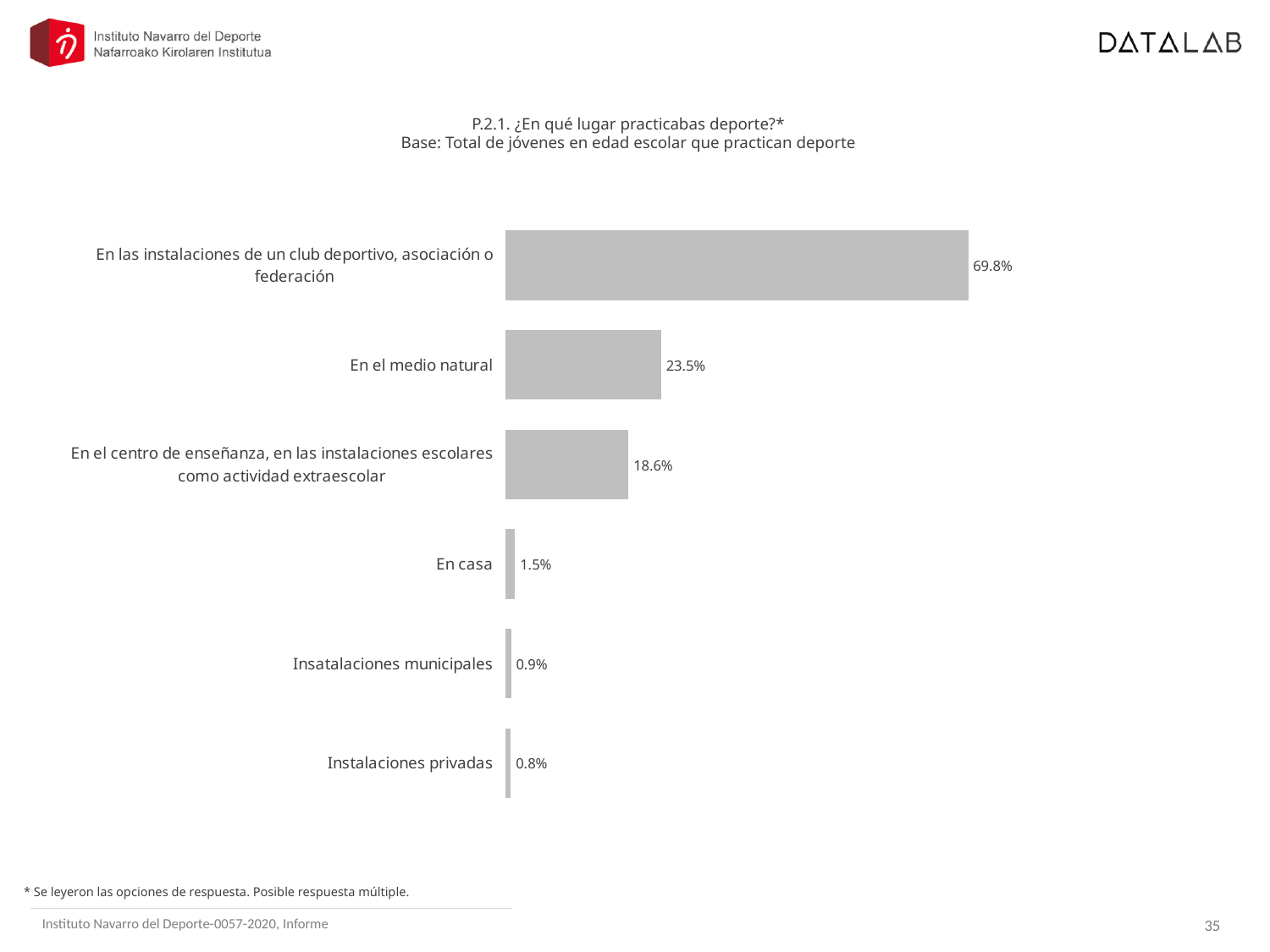
How many categories are shown in the chart? 6 What kind of chart is shown on the slide? Bar chart What is the difference between the highest and lowest values in the chart? 69% What is the difference between the values for "En el medio natural" and "En el centro de enseñanza, en las instalaciones escolares como actividad extraescolar"? 4.9% Which category has the lowest value? Instalaciones privadas What is the value for "En el medio natural"? 23.5% Which category has the highest value? En las instalaciones de un club deportivo, asociación o federación What is the value for "Instalaciones privadas"? 0.8% What is the value for "En casa"? 1.5% What is the value for "En el centro de enseñanza, en las instalaciones escolares como actividad extraescolar"? 18.6% What is the question text shown as the chart title? P.2.1. ¿En qué lugar practicabas deporte?* Which is larger: the value for "En casa" or the value for "Insatalaciones municipales"? En casa